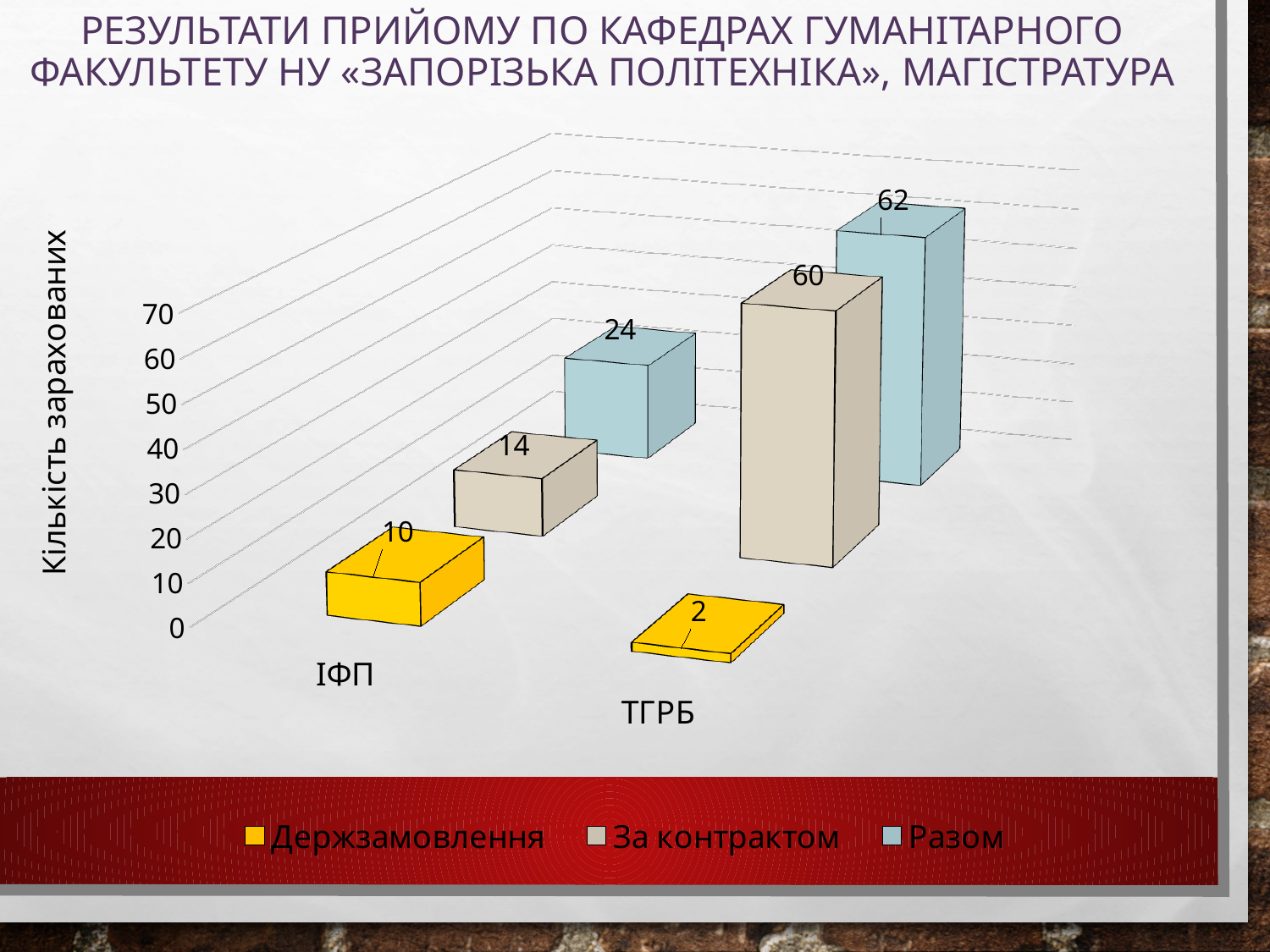
How many series does the legend list? 3 How many categories are shown on the x axis? 2 What is the value of Держзамовлення for ІФП? 10 Which is larger: Держзамовлення for ІФП or За контрактом for ІФП? За контрактом for ІФП What is the difference between the За контрактом values for ТГРБ and ІФП? 46 What is the value of Разом for ІФП? 24 Which category has the lowest Держзамовлення value? ТГРБ What is the value of Держзамовлення for ТГРБ? 2 What is the value of За контрактом for ТГРБ? 60 What kind of chart is shown on the slide? Bar chart What is the label of the vertical axis? Кількість зарахованих Which category has the highest Разом value? ТГРБ